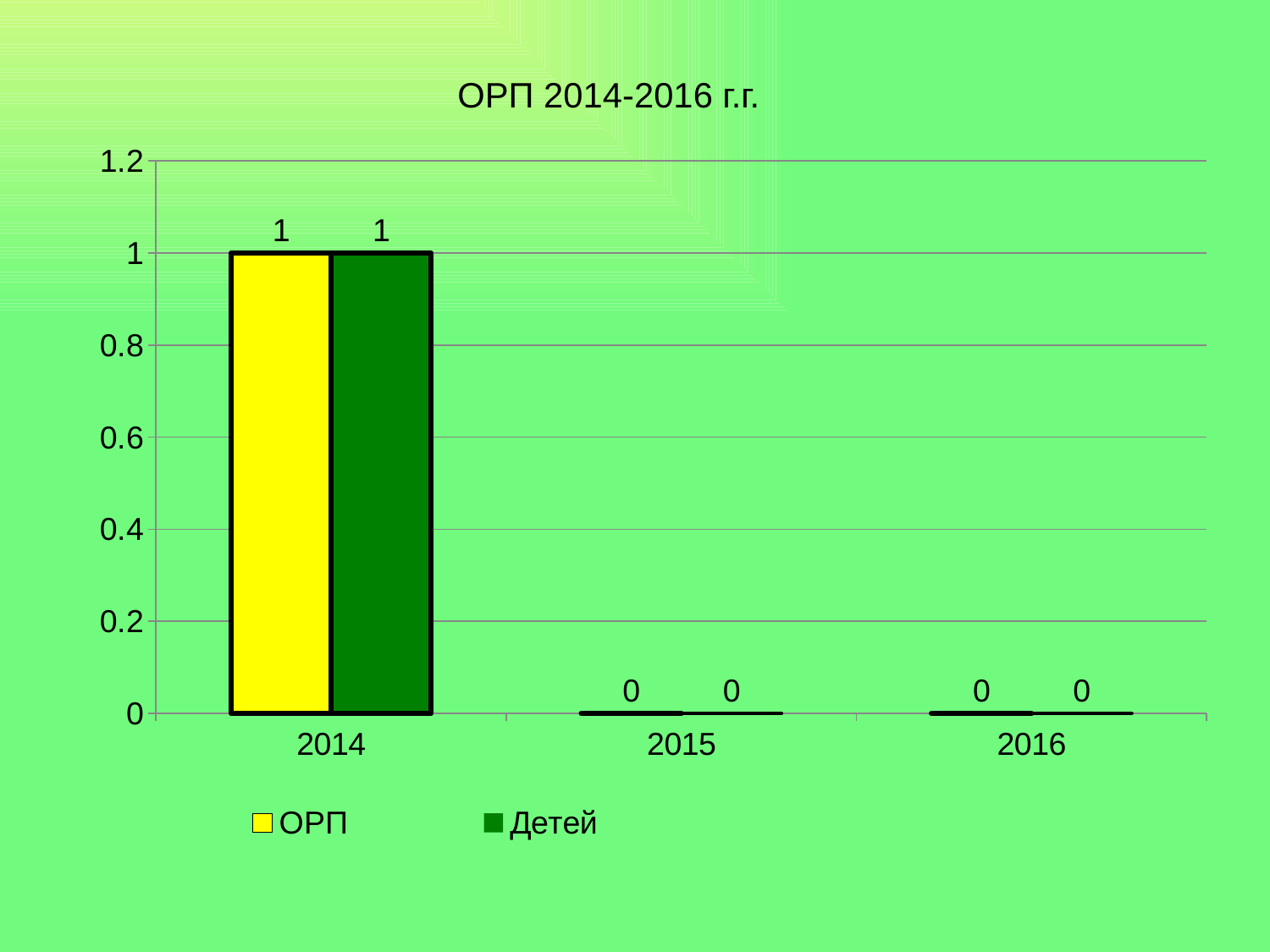
What is the title of the chart? ОРП 2014-2016 г.г. How many series does the legend list? 2 What is the value for ОРП in 2014? 1 Which is larger: the Детей value in 2014 or the Детей value in 2016? 2014 What is the value for ОРП in 2016? 0 What is the difference between the ОРП value in 2014 and the ОРП value in 2015? 1 What colour represents the Детей series? green How many years are shown on the x axis? 3 What is the value for Детей in 2015? 0 What kind of chart is shown on the slide? bar chart Which year has the highest value for ОРП? 2014 Do the ОРП values rise or fall from 2014 to 2016? fall